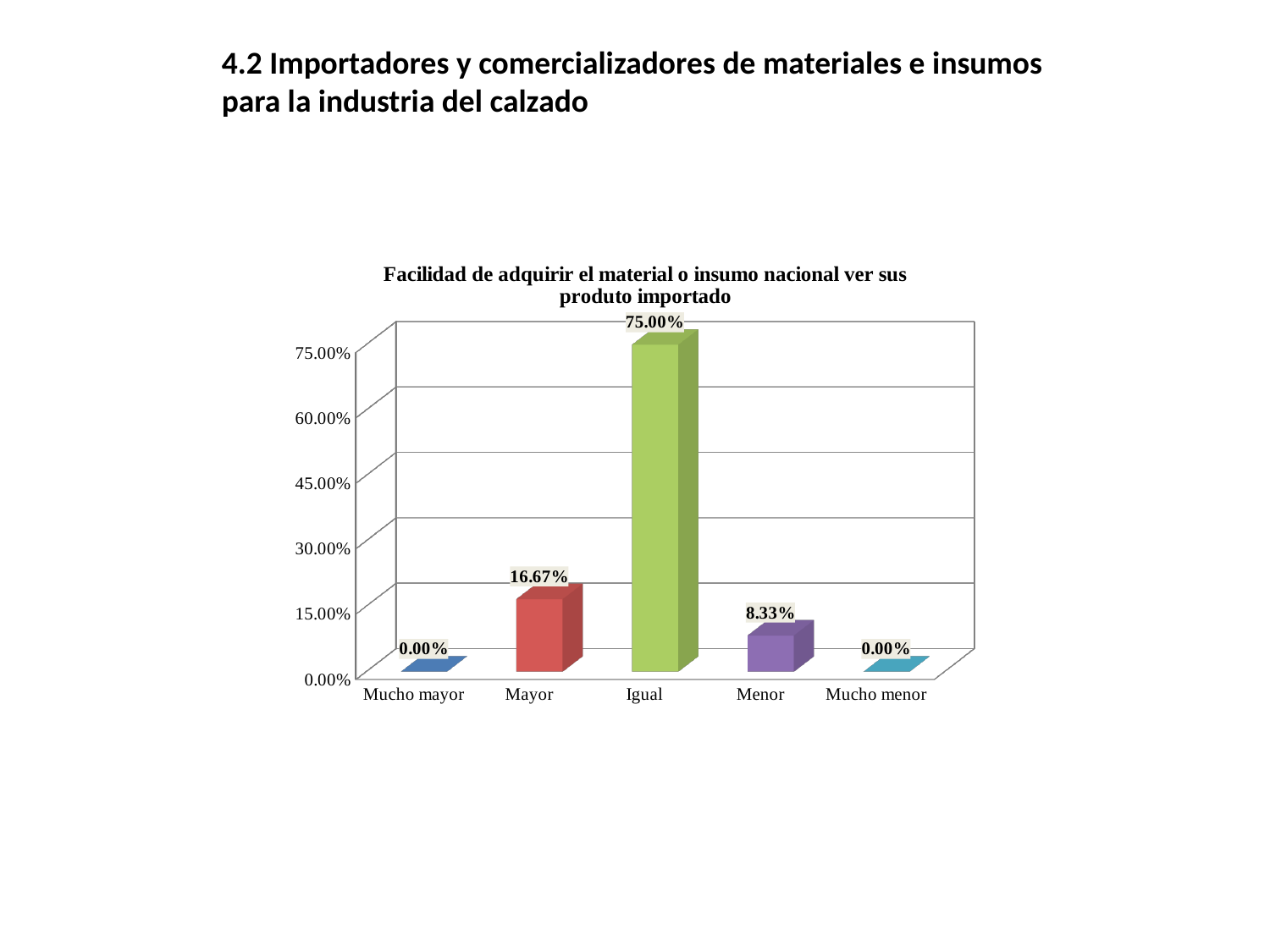
What is the value for Igual? 75.00% What kind of chart is shown on the slide? bar chart What is the value for Menor? 8.33% What is the difference between the values for Igual and Mayor? 58.33% Is the value for Igual greater or less than 60.00%? greater Which category has the highest value? Igual What is the value for Mayor? 16.67% What is the difference between the values for Mayor and Menor? 8.34% How many categories are shown on the x axis? 5 What is the value for Mucho mayor? 0.00% What is the title of the chart? Facilidad de adquirir el material o insumo nacional ver sus produto importado Which is larger, the value for Mayor or the value for Menor? Mayor